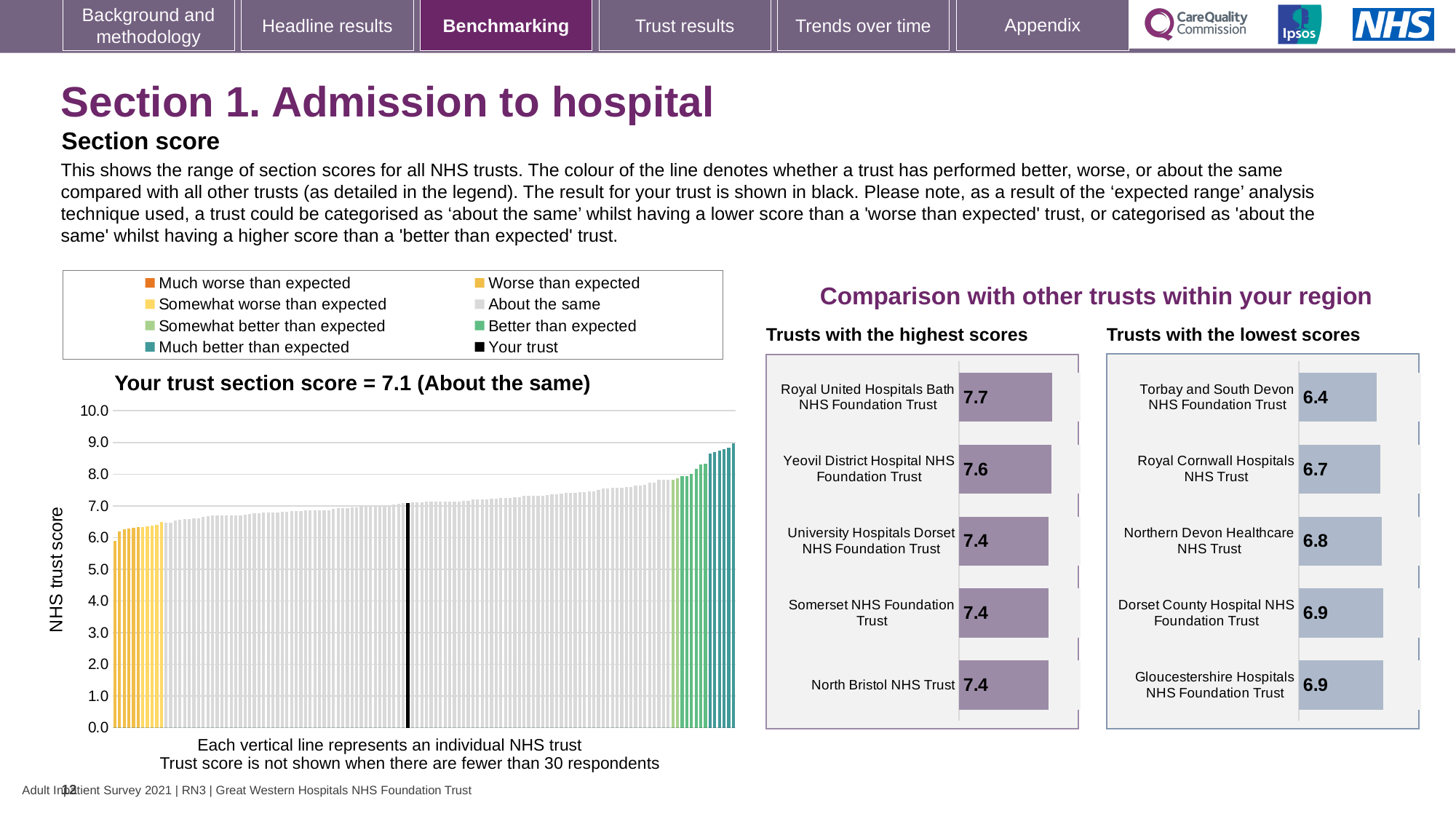
In the 'Trusts with the highest scores' chart, which trust has the highest score? Royal United Hospitals Bath NHS Foundation Trust In the 'Your trust section score' chart, do the bars rise or fall from left to right along the x axis? rise What kind of chart is the 'Your trust section score' chart? bar chart In the 'Trusts with the highest scores' chart, what is the score for Royal United Hospitals Bath NHS Foundation Trust? 7.7 In the 'Trusts with the lowest scores' chart, which has the higher score: Northern Devon Healthcare NHS Trust or Royal Cornwall Hospitals NHS Trust? Northern Devon Healthcare NHS Trust In the 'Your trust section score' chart, what is the section score for your trust? 7.1 In the 'Trusts with the lowest scores' chart, which trust has the lowest score? Torbay and South Devon NHS Foundation Trust In the 'Trusts with the highest scores' chart, what is the difference between the scores of Royal United Hospitals Bath NHS Foundation Trust and Yeovil District Hospital NHS Foundation Trust? 0.1 What is the y-axis label of the 'Your trust section score' chart? NHS trust score In the 'Trusts with the highest scores' chart, how many trusts are shown? 5 In the 'Trusts with the lowest scores' chart, what is the score for Torbay and South Devon NHS Foundation Trust? 6.4 How many entries does the legend above the 'Your trust section score' chart list? 8